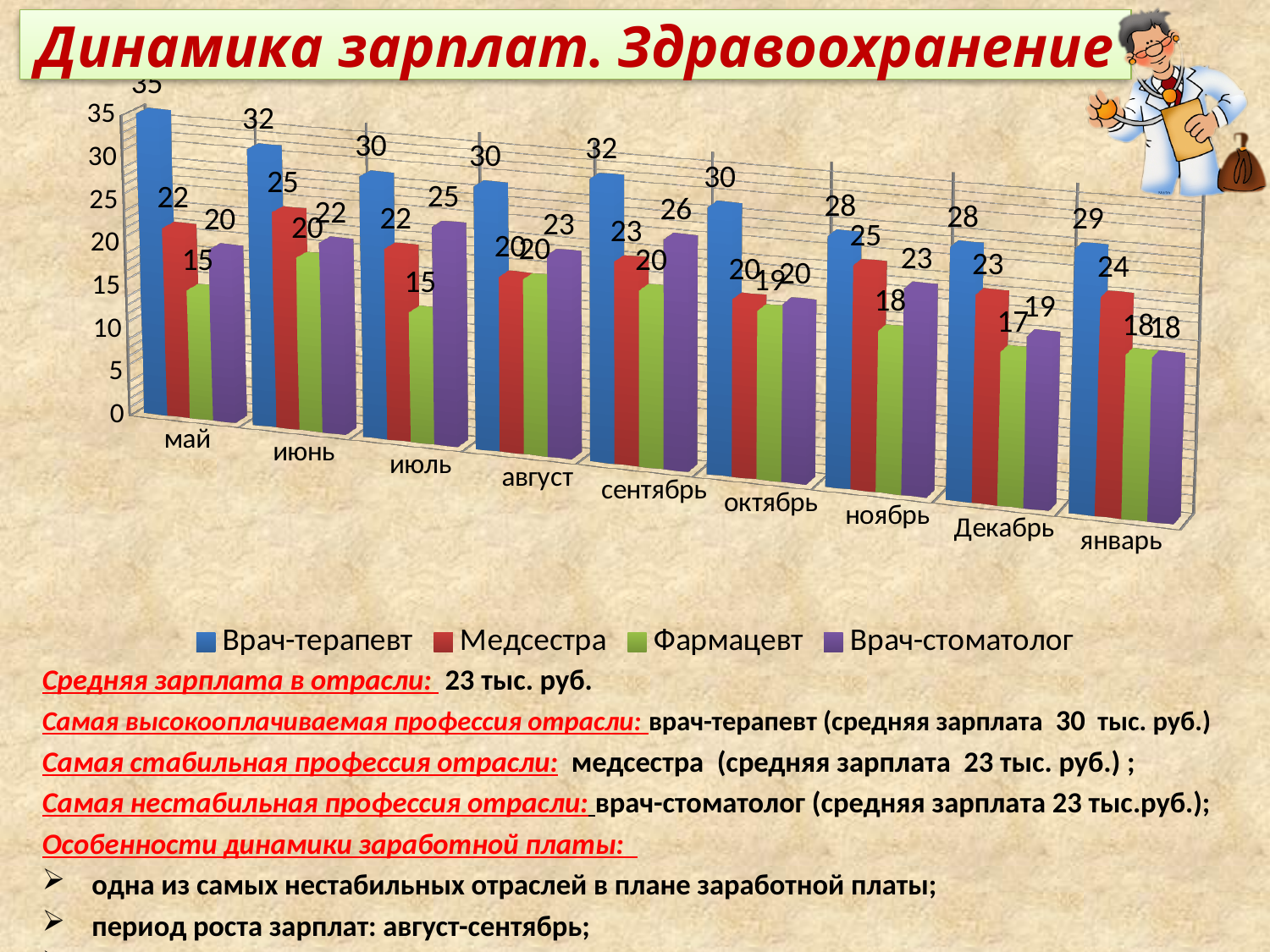
What is the difference between the values for Врач-терапевт and Медсестра in май? 13 What is the value for Медсестра in ноябрь? 25 What is the value for Врач-терапевт in май? 35 In which month is the value for Врач-терапевт the highest? май In which month is the value for Врач-стоматолог the lowest? январь In июль, which is larger: the value for Фармацевт or for Врач-стоматолог? Врач-стоматолог Does the value for Врач-терапевт rise or fall from май to июль? fall How many series does the legend list? 4 What is the value for Фармацевт in Декабрь? 17 What is the value for Врач-стоматолог in сентябрь? 26 What kind of chart is shown on the slide? bar chart How many months are shown on the x axis? 9